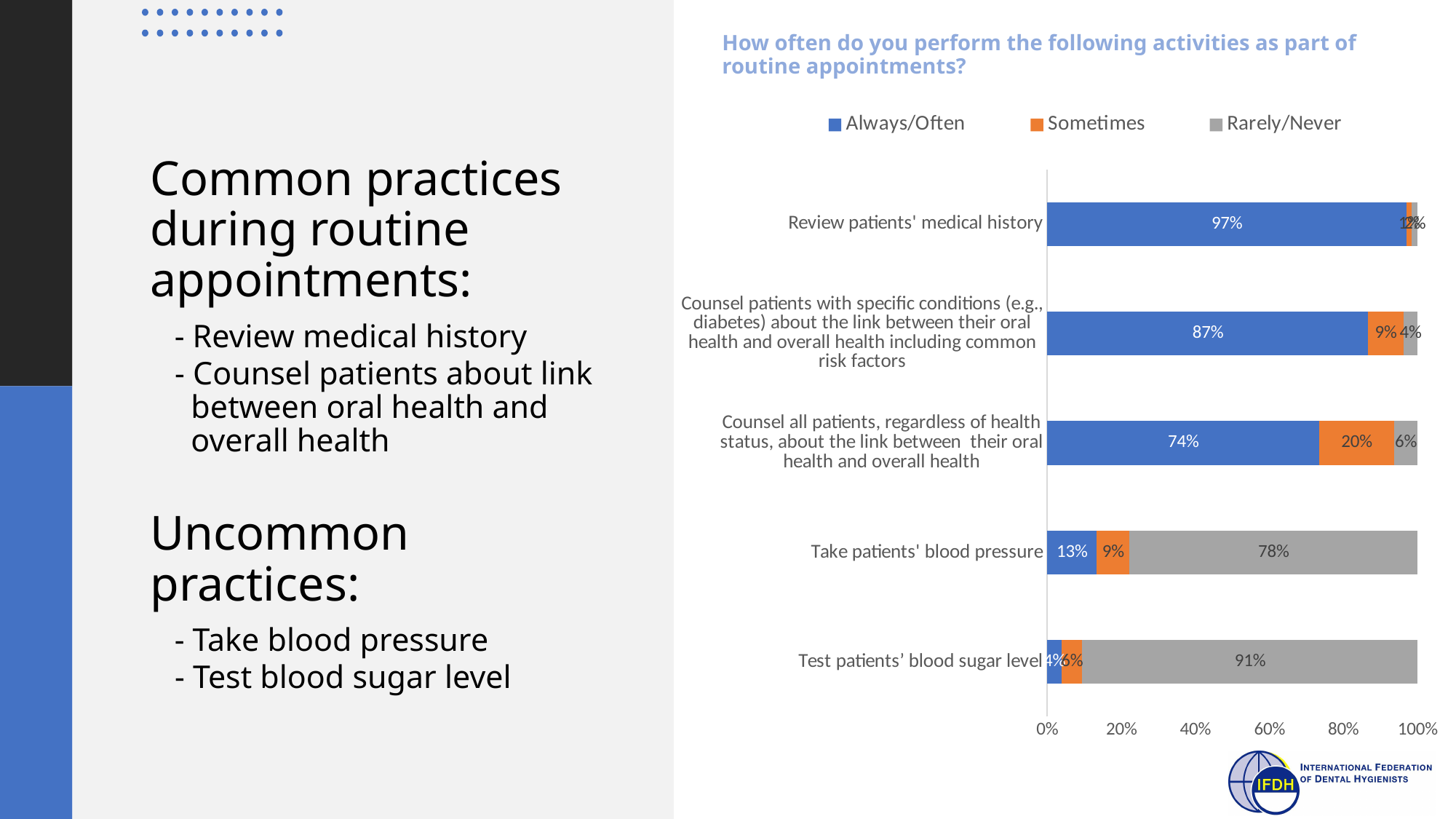
What is the Rarely/Never value for 'Take patients' blood pressure'? 78% What type of chart is shown on the slide? Stacked bar chart Which is larger: the Rarely/Never value for 'Take patients' blood pressure' or the Rarely/Never value for 'Test patients' blood sugar level'? Test patients' blood sugar level What is the Sometimes value for 'Counsel all patients, regardless of health status, about the link between their oral health and overall health'? 20% What is the Rarely/Never value for 'Test patients' blood sugar level'? 91% Which activity has the lowest Always/Often value? Test patients' blood sugar level Which activity has the highest Always/Often value? Review patients' medical history What is the Always/Often value for 'Review patients' medical history'? 97% How many series does the chart legend list? 3 What is the difference between the Always/Often values for 'Counsel patients with specific conditions...' (87%) and 'Counsel all patients, regardless of health status...' (74%)? 13% Which legend entry is shown in orange? Sometimes How many activities (categories) are shown in the chart? 5